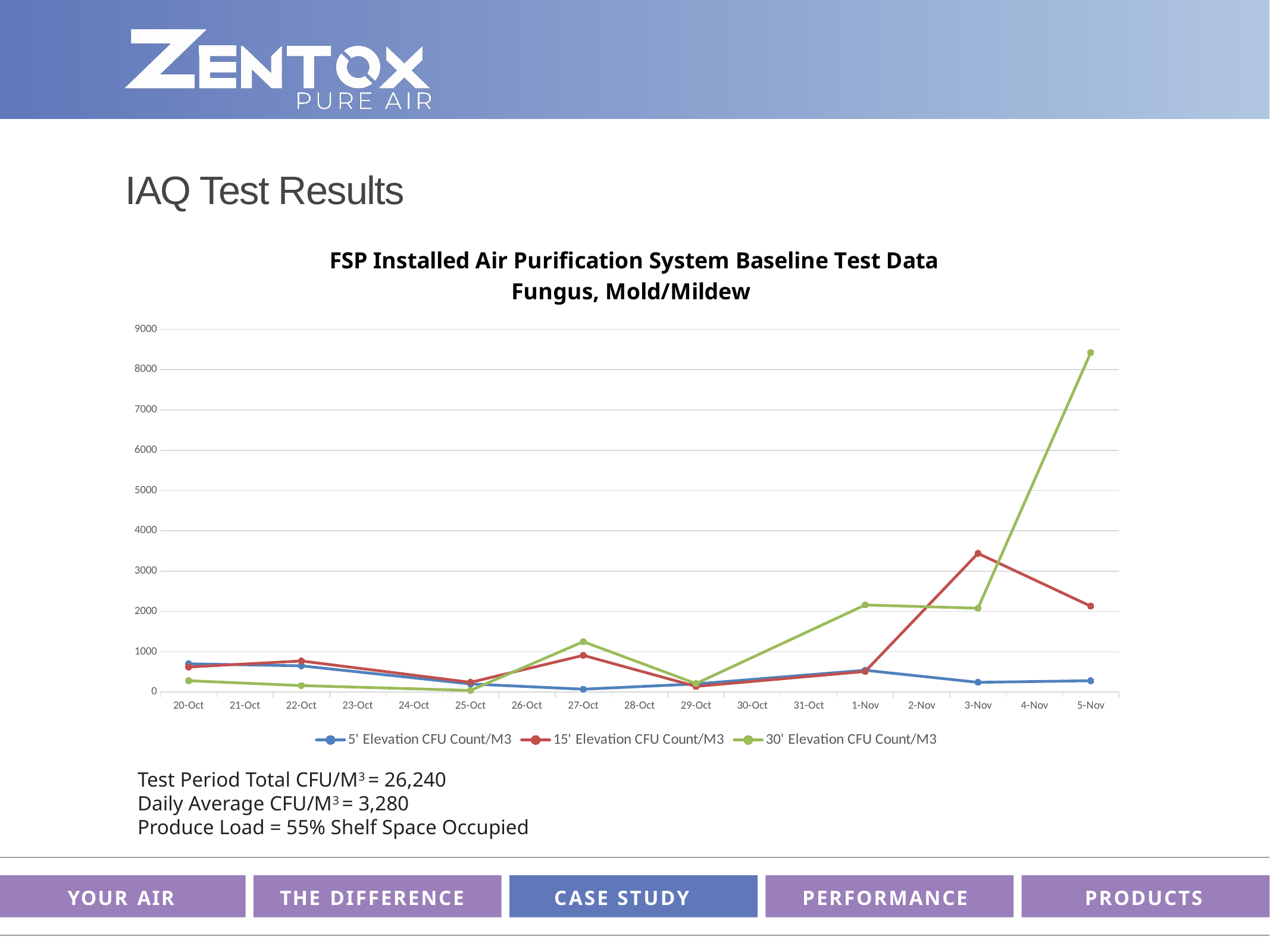
On which date does the 30' Elevation CFU Count/M3 series reach its highest value? 5-Nov Is the value for 30' Elevation CFU Count/M3 on 5-Nov greater or less than 8000? greater On which date does the 30' Elevation CFU Count/M3 series reach its lowest value? 25-Oct On which date does the 15' Elevation CFU Count/M3 series reach its highest value? 3-Nov Is the value for 5' Elevation CFU Count/M3 on 5-Nov greater or less than 1000? less On 3-Nov, which is larger: the 15' Elevation CFU Count/M3 value or the 5' Elevation CFU Count/M3 value? 15' Elevation CFU Count/M3 Is the value for 15' Elevation CFU Count/M3 on 3-Nov greater or less than 3000? greater Which series has the highest value on 5-Nov? 30' Elevation CFU Count/M3 How many series does the legend list? 3 What is the title of the chart? FSP Installed Air Purification System Baseline Test Data Fungus, Mold/Mildew What kind of chart is shown on the slide? line chart How many date labels are shown along the x axis? 17